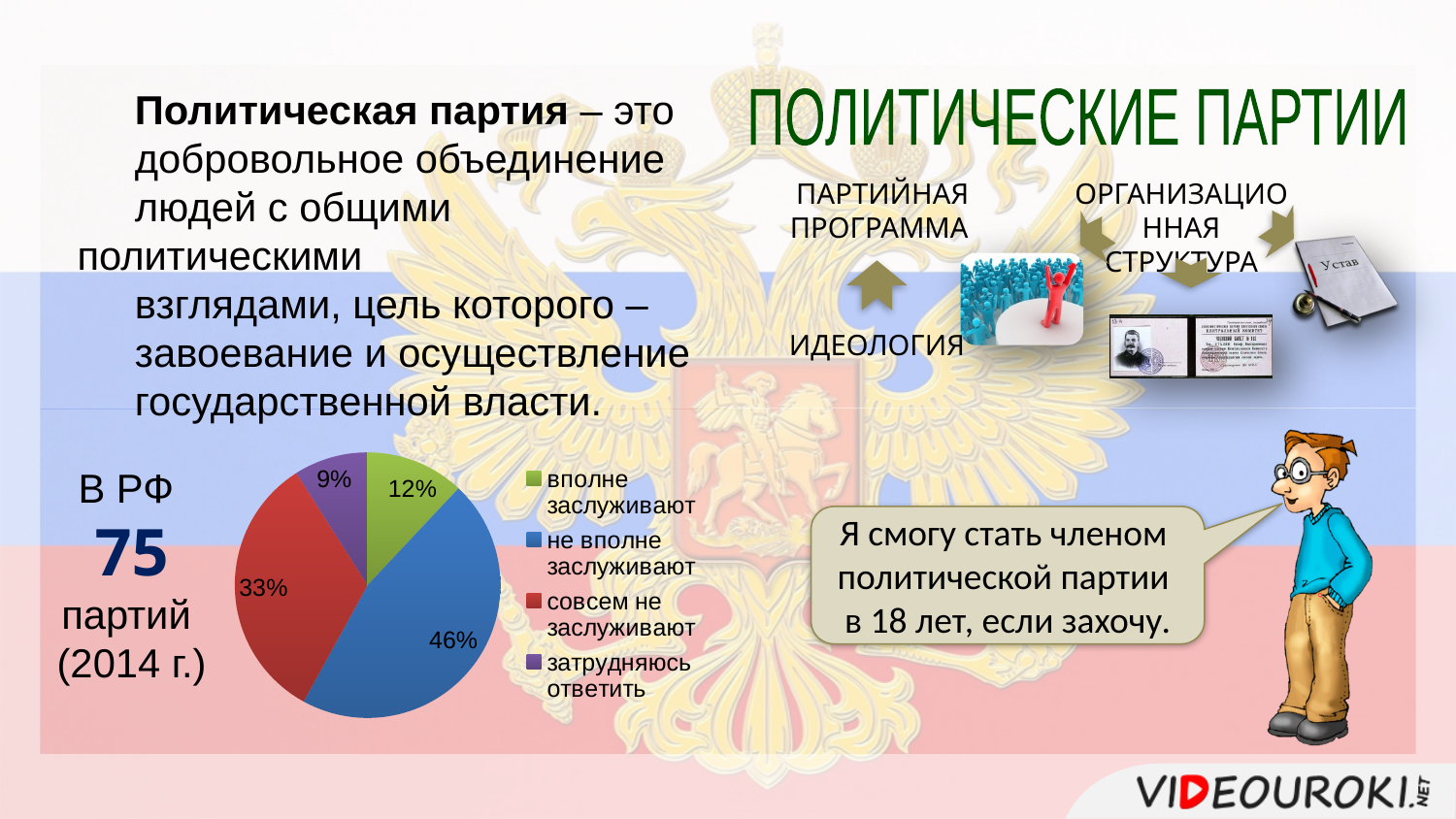
How many categories does the pie chart have? 4 What is the difference in percentage points between "не вполне заслуживают" and "совсем не заслуживают"? 13 What share of the pie chart is labelled "вполне заслуживают"? 12% What kind of chart is shown on the slide? pie chart What share of the pie chart is labelled "совсем не заслуживают"? 33% What colour is the slice for "не вполне заслуживают" in the pie chart? blue What share of the pie chart is labelled "не вполне заслуживают"? 46% What colour is the slice for "совсем не заслуживают" in the pie chart? red Which category has the largest slice in the pie chart? не вполне заслуживают Which category has the smallest slice in the pie chart? затрудняюсь ответить What share of the pie chart is labelled "затрудняюсь ответить"? 9% Which is larger in the pie chart: "вполне заслуживают" or "затрудняюсь ответить"? вполне заслуживают